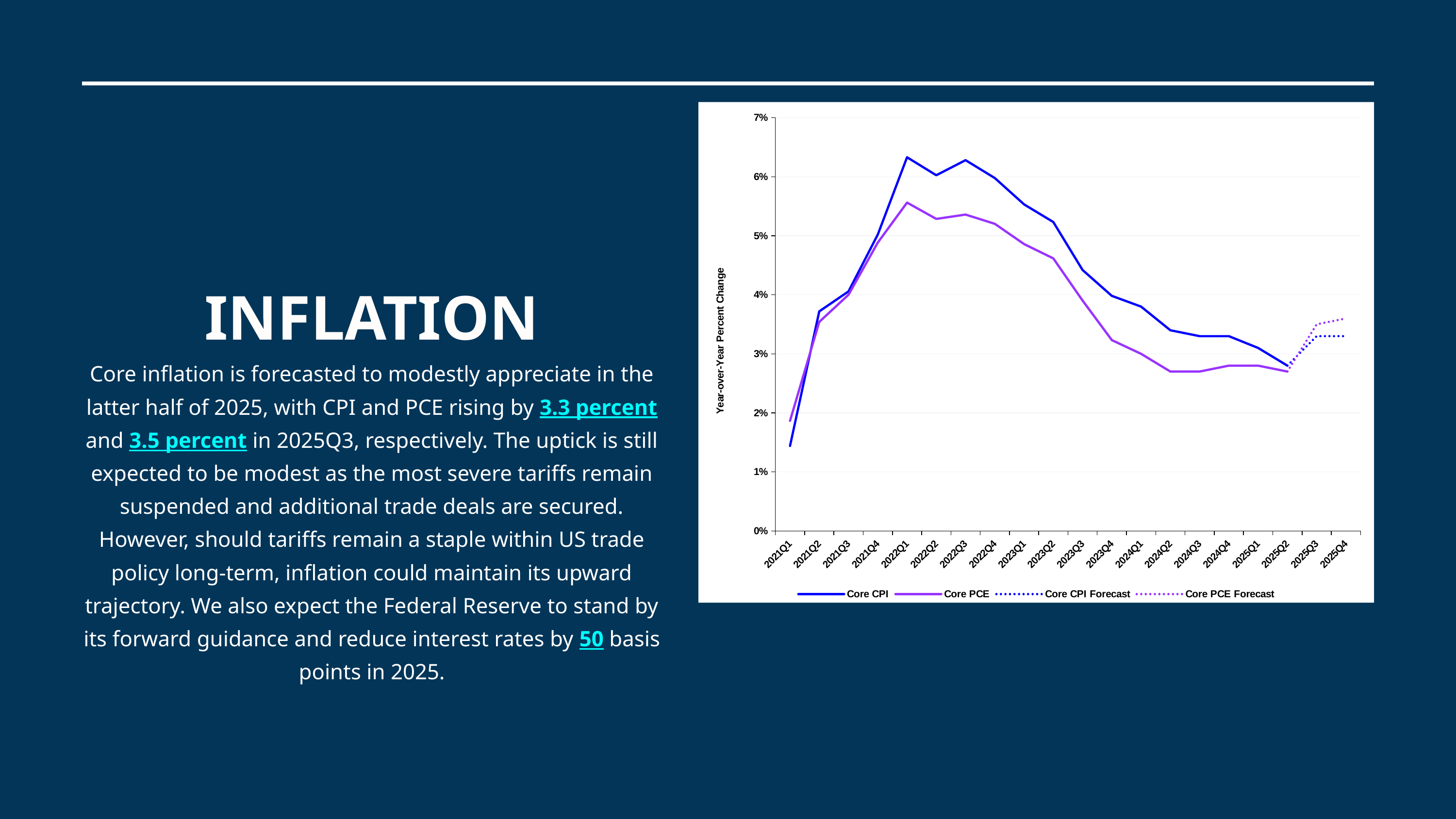
Does Core CPI rise or fall between 2022Q1 and 2025Q2? fall Is the Core PCE value for 2021Q1 greater or less than 2%? less Is the Core CPI value for 2023Q2 greater or less than 5%? greater Is the Core CPI value for 2022Q1 greater or less than 6%? greater In 2022Q1, which is higher, Core CPI or Core PCE? Core CPI How many quarters are labelled along the x axis of the chart? 20 What kind of chart is shown on the slide? line chart How many series does the chart's legend list? 4 Which legend entries are drawn as dotted lines in the chart? Core CPI Forecast and Core PCE Forecast What is the title of the chart's y axis? Year-over-Year Percent Change